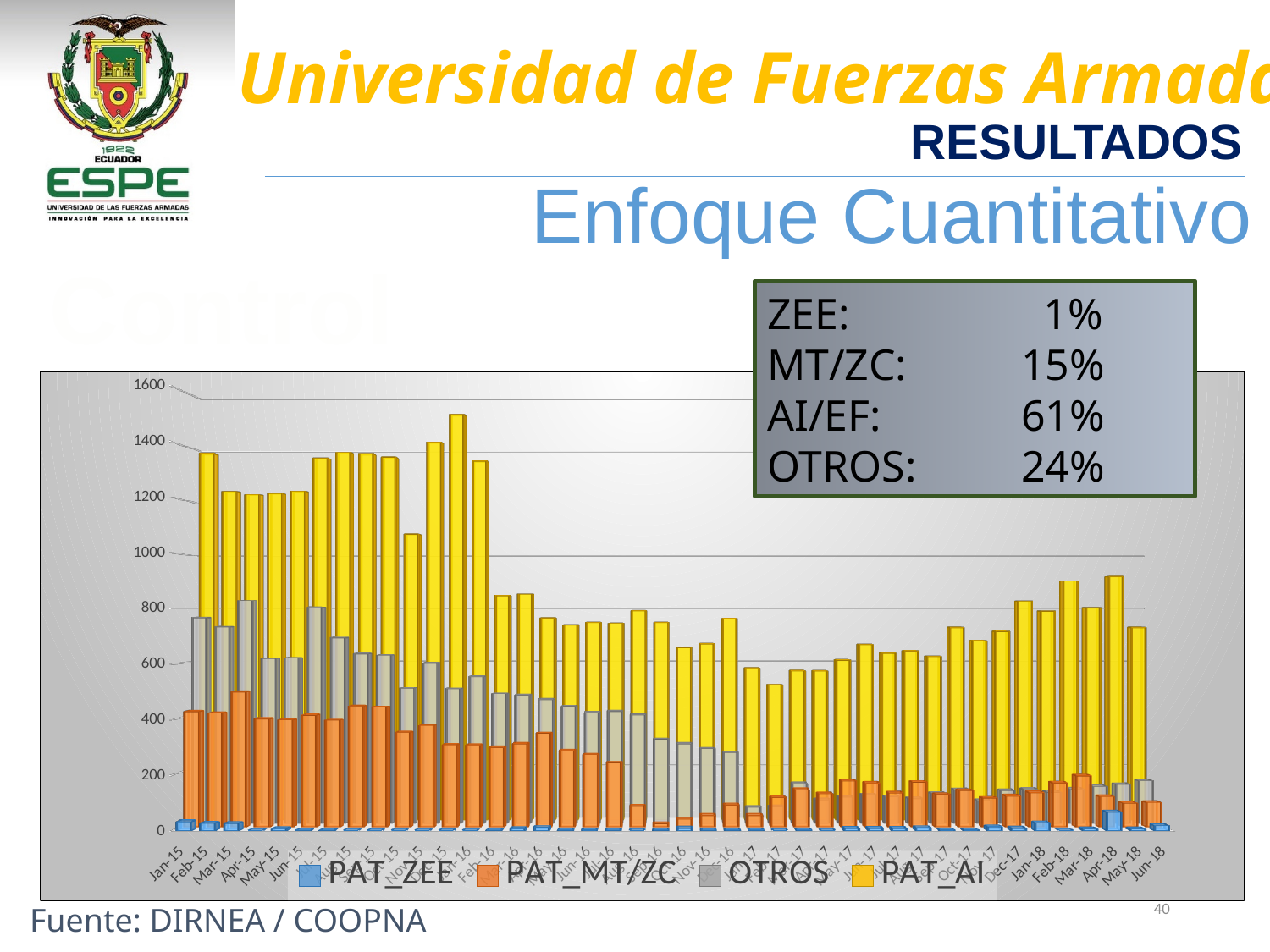
What kind of chart is shown on the slide? bar chart Which series has the shortest bars in the chart? PAT_ZEE Is the OTROS value for Jan-15 greater or less than 600? greater Overall, do the PAT_AI values rise or fall from Jan-15 to Jun-18? fall Which series has the tallest bars in the chart? PAT_AI Is the PAT_AI value for Jun-18 greater or less than 800? less Is the PAT_ZEE value for Jan-15 greater or less than 200? less What are the series names listed in the chart's legend? PAT_ZEE, PAT_MT/ZC, OTROS, PAT_AI How many series does the chart's legend list? 4 In Jan-15, which is larger: PAT_AI or PAT_MT/ZC? PAT_AI